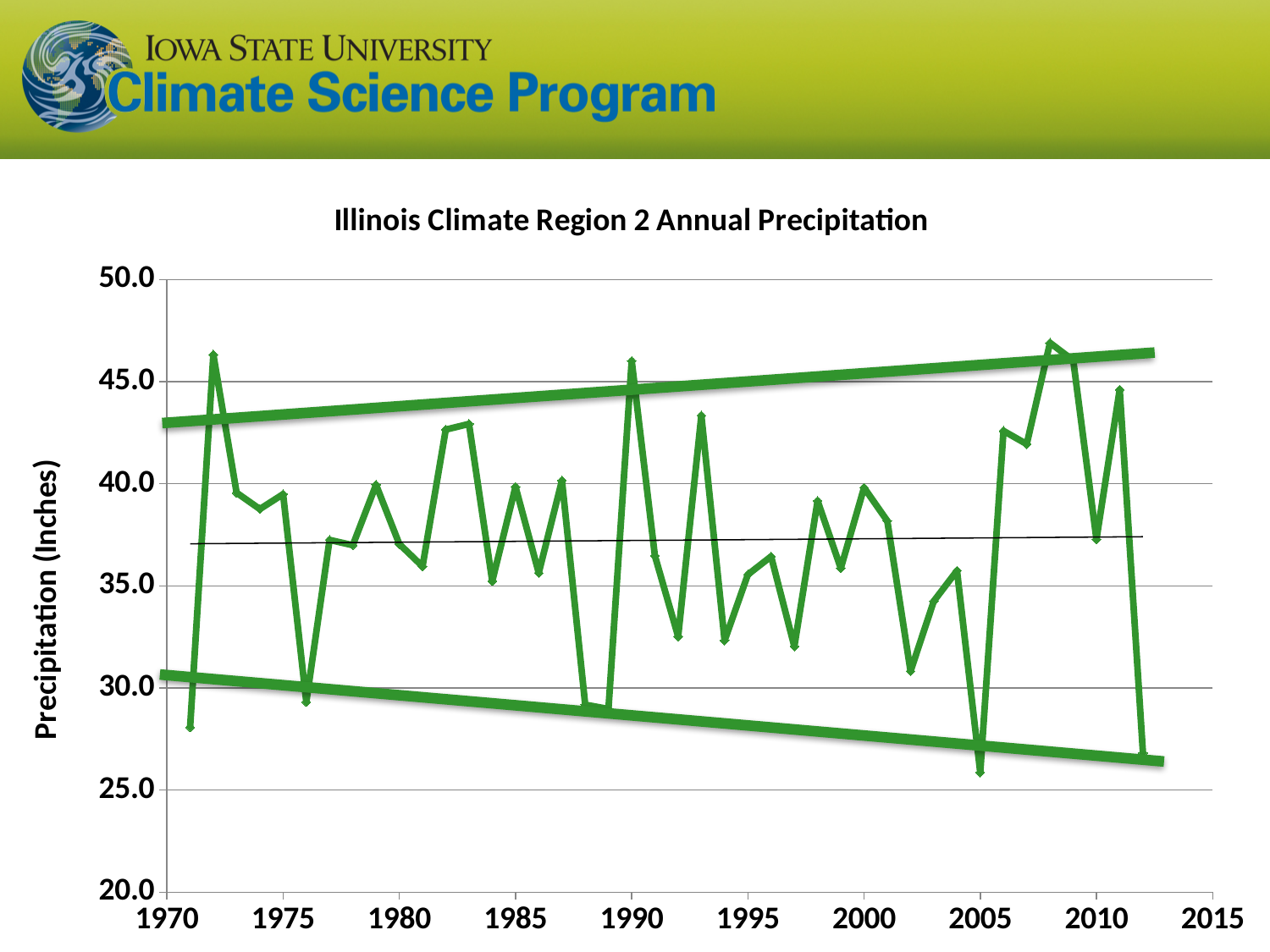
Which year has the higher precipitation, 1971 or 1972? 1972 What is the label on the vertical axis of the chart? Precipitation (Inches) Which year has the higher precipitation, 2005 or 2006? 2006 Does the thick upper trend line rise or fall from 1970 to 2013? Rises Is the precipitation value for 2005 greater or less than 30.0? less Is the precipitation value for 1990 greater or less than 45.0? greater Is the precipitation value for 1971 greater or less than 30.0? less What kind of chart is shown on the slide? Line chart What is the title of the chart? Illinois Climate Region 2 Annual Precipitation